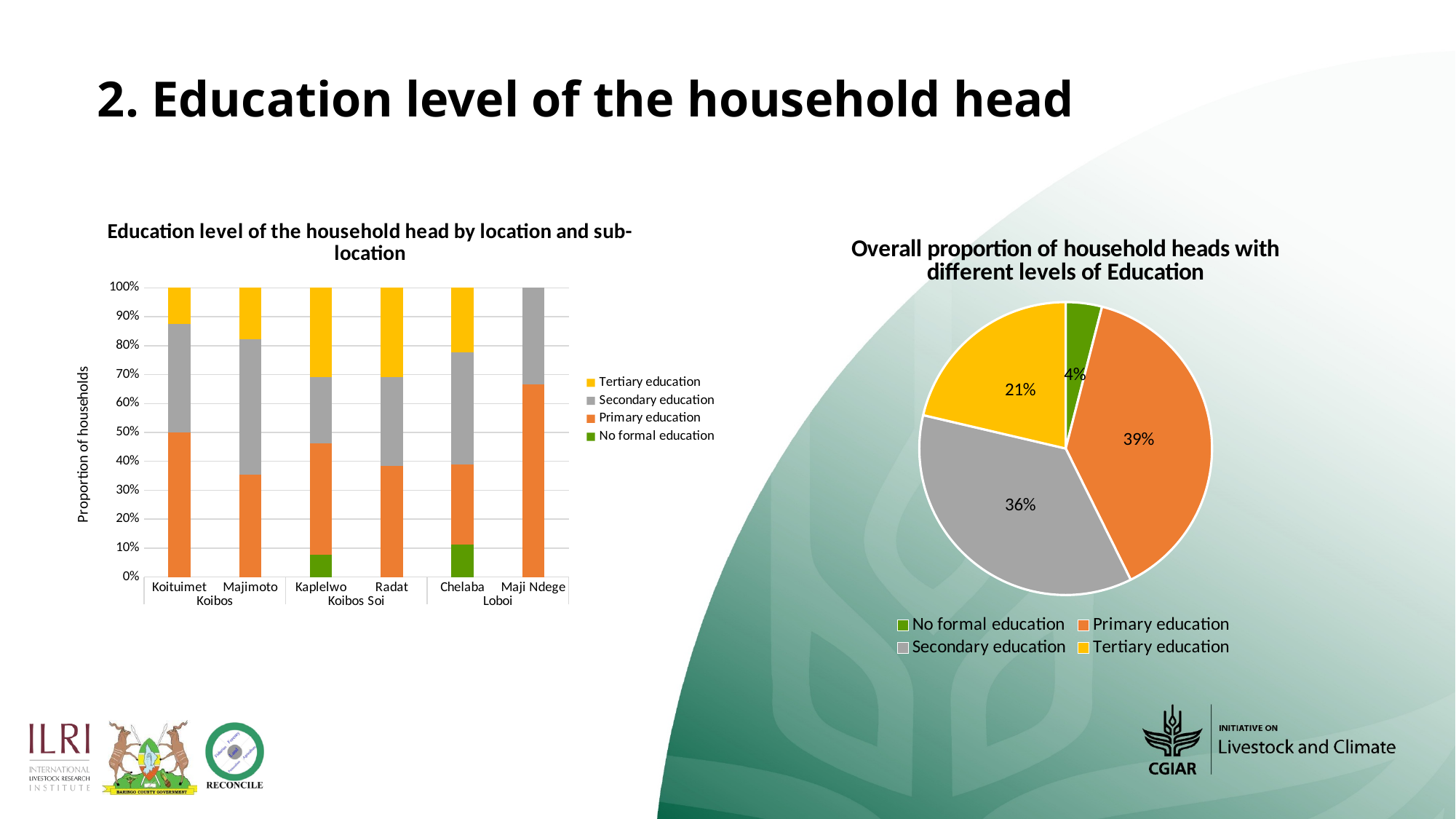
In the chart 'Education level of the household head by location and sub-location', how many series does the legend list? 4 In the pie chart 'Overall proportion of household heads with different levels of Education', what share of household heads have no formal education? 4% In the chart 'Education level of the household head by location and sub-location', which sub-location has no tertiary education segment? Maji Ndege In the pie chart 'Overall proportion of household heads with different levels of Education', which education level has the smallest share? No formal education In the chart 'Education level of the household head by location and sub-location', how many sub-locations are shown on the x axis? 6 In the chart 'Education level of the household head by location and sub-location', is the primary education proportion for Maji Ndege greater or less than 60%? greater In the pie chart 'Overall proportion of household heads with different levels of Education', what share of household heads have primary education? 39% In the pie chart 'Overall proportion of household heads with different levels of Education', which education level has the largest share? Primary education What kind of chart is 'Education level of the household head by location and sub-location'? Stacked bar chart In the pie chart 'Overall proportion of household heads with different levels of Education', how many slices does the pie have? 4 In the pie chart 'Overall proportion of household heads with different levels of Education', what is the difference between the secondary education share and the tertiary education share? 15% In the chart 'Education level of the household head by location and sub-location', is the primary education proportion for Majimoto greater or less than 40%? less